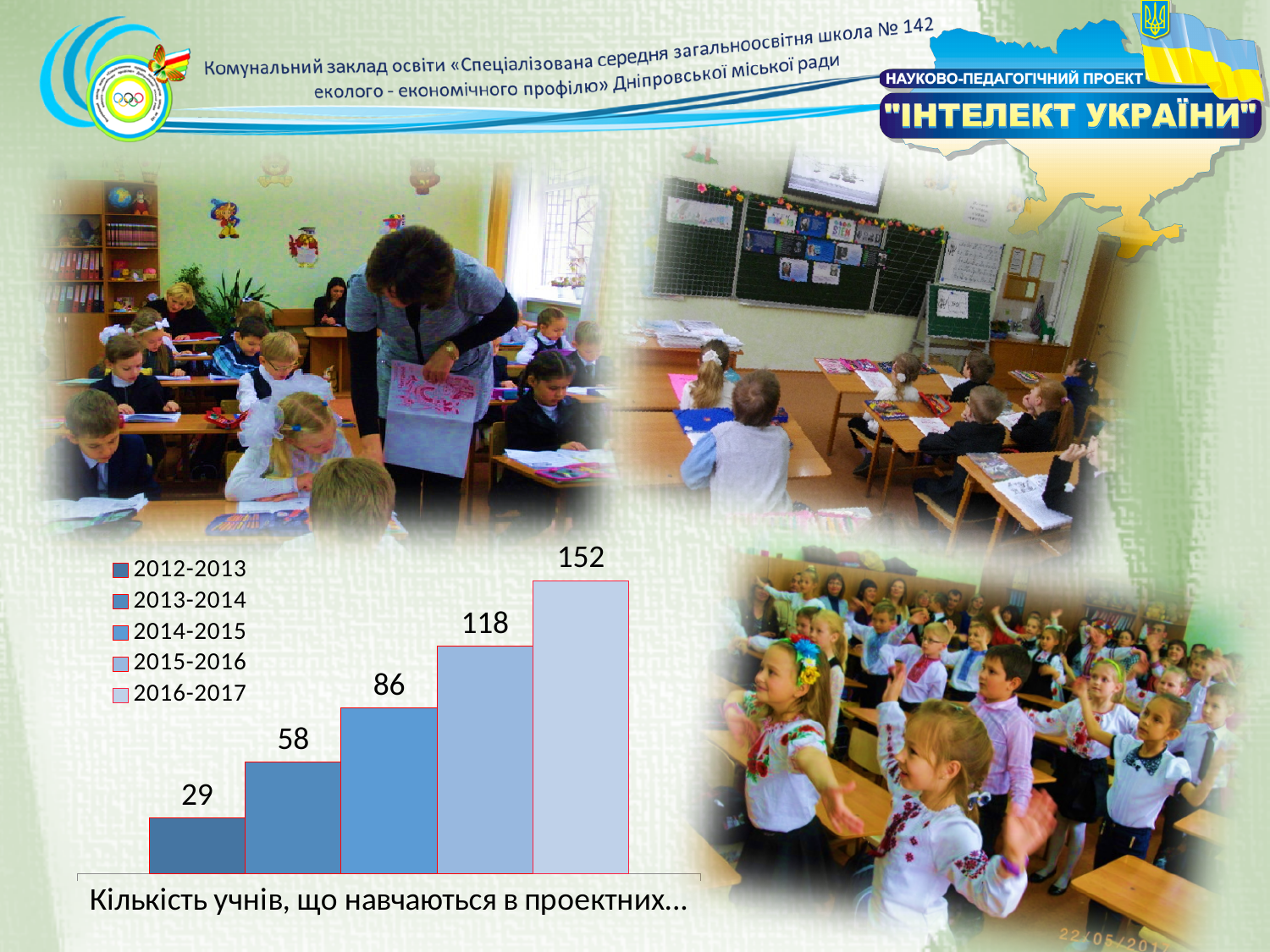
Which school year has the highest value? 2016-2017 Which school year has the lowest value? 2012-2013 What is the value for 2014-2015? 86 What is the value for 2012-2013? 29 Do the values rise or fall from 2012-2013 to 2016-2017? rise What is the value for 2013-2014? 58 What is the value for 2016-2017? 152 What type of chart is shown on the slide? bar chart What is the value for 2015-2016? 118 What is the difference between the values for 2016-2017 and 2015-2016? 34 Which is larger, the value for 2013-2014 or the value for 2014-2015? 2014-2015 How many bars are plotted in the chart? 5